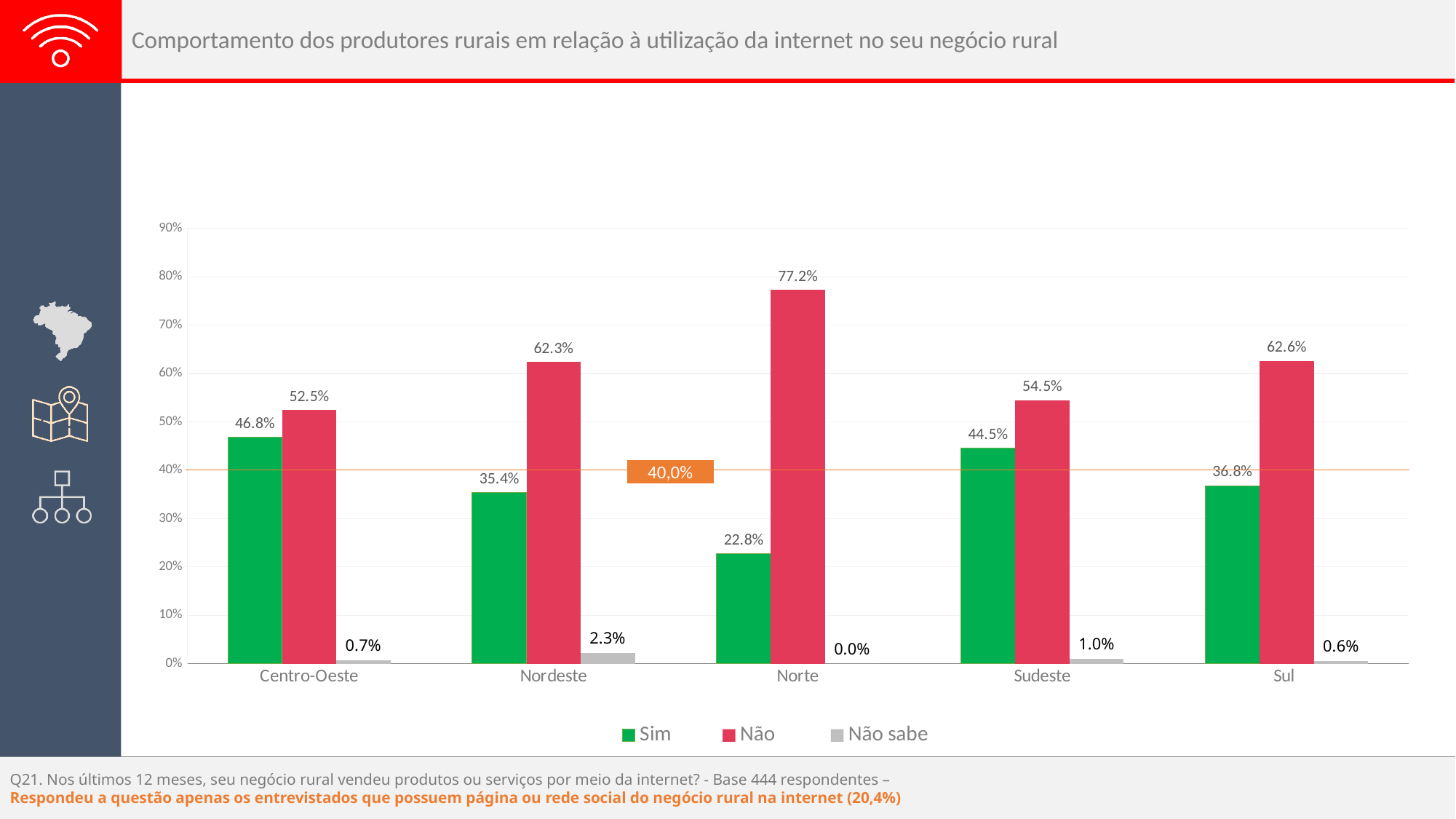
What value is shown in the orange label on the chart? 40,0% What is the value of 'Sim' for Centro-Oeste? 46.8% What kind of chart is shown? bar chart How many regions are shown on the x axis? 5 Is the 'Sim' value for Nordeste greater or less than 40%? less Which region has the highest 'Não' value? Norte What is the value of 'Não sabe' for Nordeste? 2.3% What is the difference between 'Não' and 'Sim' for Sul? 25.8% What is the value of 'Não' for Norte? 77.2% Which region has the lowest 'Sim' value? Norte Which is larger for Sudeste: 'Sim' or 'Não'? Não How many series does the legend list? 3